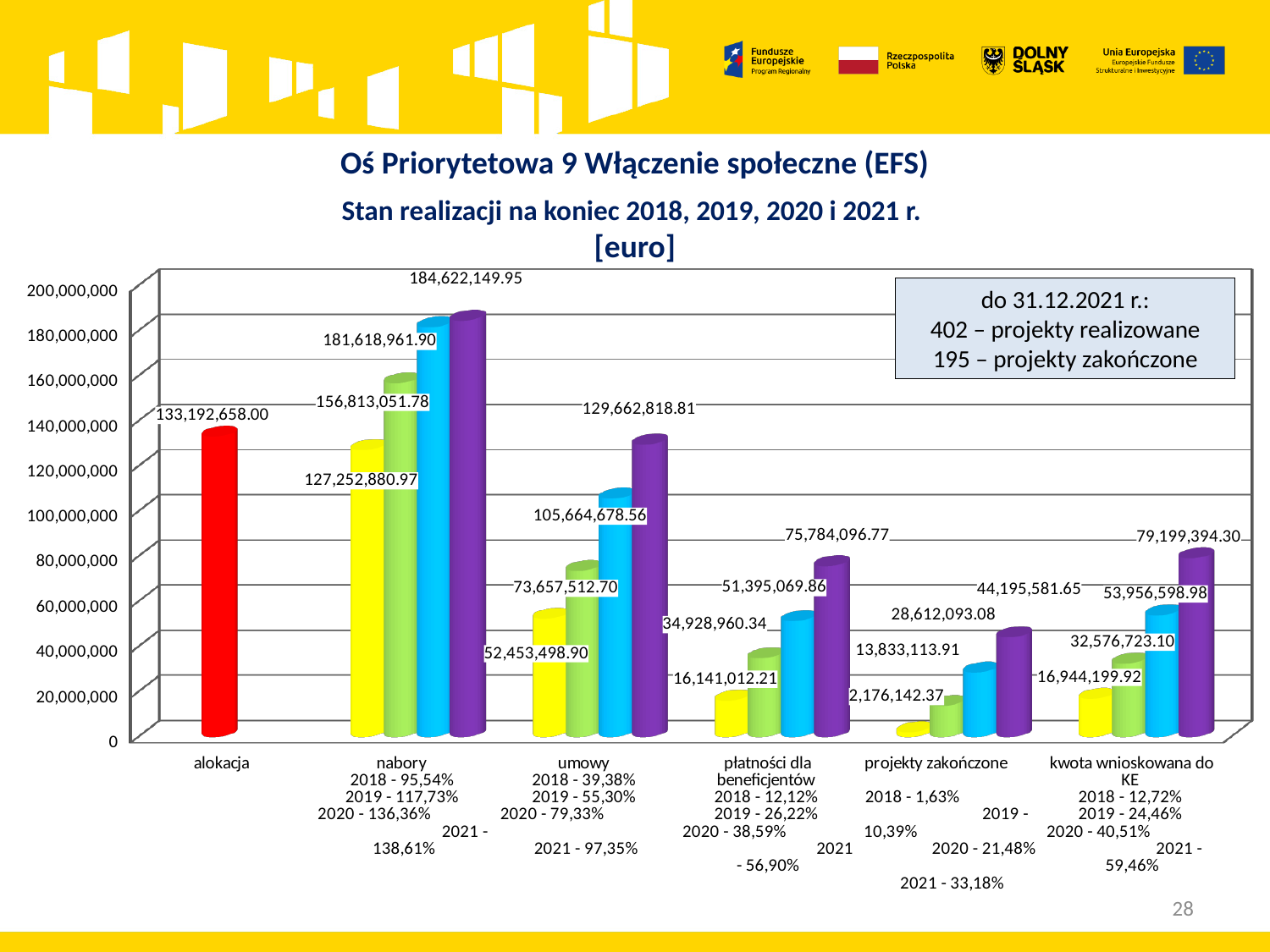
What kind of chart is shown on the slide? bar chart Which is larger: the tallest bar in the płatności dla beneficjentów group or the tallest bar in the kwota wnioskowana do KE group? kwota wnioskowana do KE What is the value of the tallest bar in the kwota wnioskowana do KE group? 79,199,394.30 How many categories are shown along the x axis of the chart? 6 What is the value of the tallest bar in the projekty zakończone group? 44,195,581.65 Within the umowy group, do the bars rise or fall from left to right? rise What is the difference between the tallest bar in the nabory group (184,622,149.95) and the alokacja bar (133,192,658.00)? 51,429,491.95 Which category group contains the highest bar on the chart? nabory Which category group contains the lowest bar on the chart? projekty zakończone What is the value of the alokacja bar? 133,192,658.00 What is the value of the shortest (leftmost, yellow) bar in the umowy group? 52,453,498.90 What is the value of the tallest bar in the nabory group? 184,622,149.95